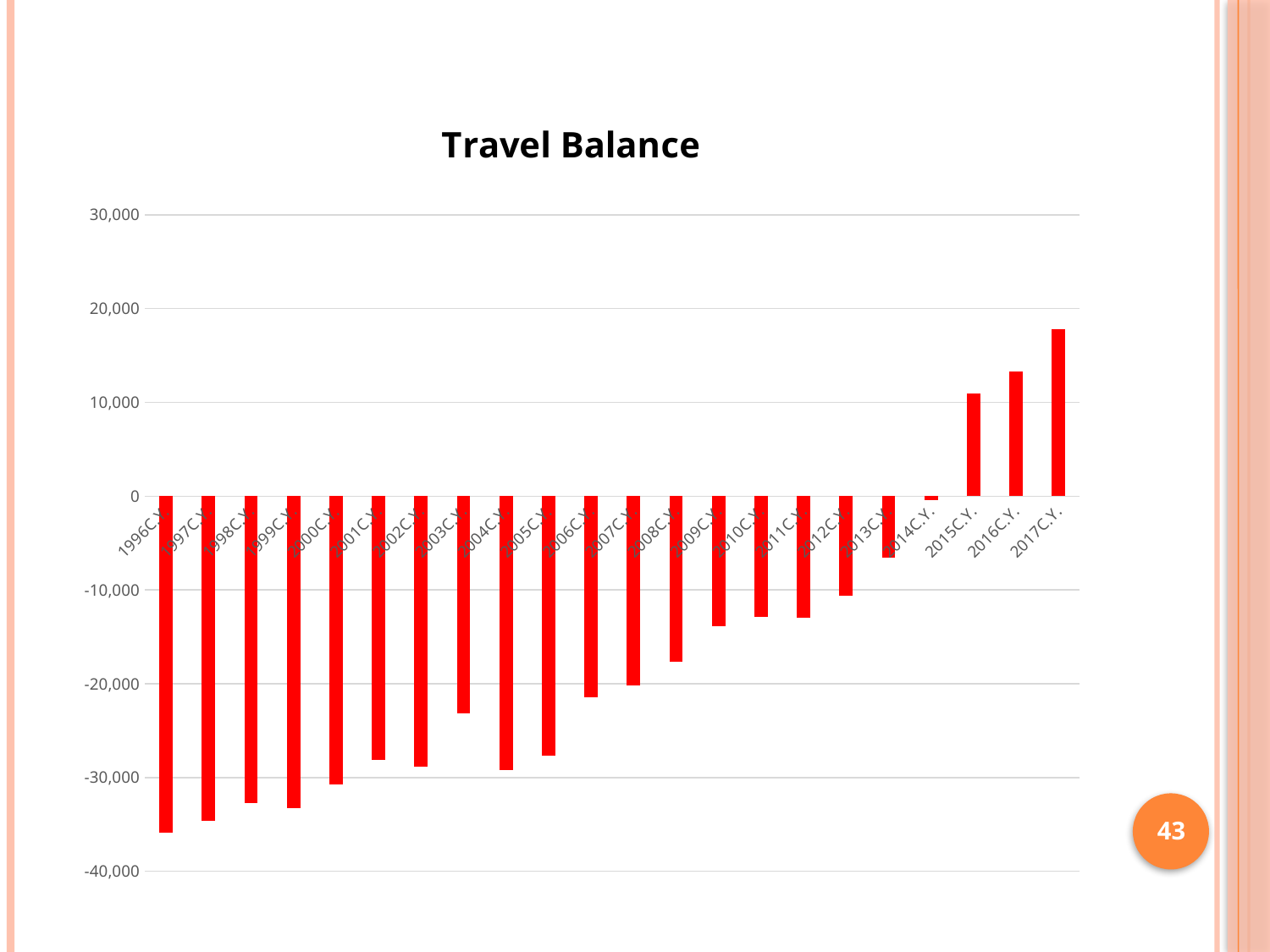
Overall, do the values rise or fall from 1996C.Y. to 2017C.Y.? rise What is the title of the chart? Travel Balance Is the value for 2013C.Y. greater or less than -10,000? greater How many years show a positive travel balance (bar above zero)? 3 Which is larger, the value for 2003C.Y. or the value for 2004C.Y.? 2003C.Y. What kind of chart is shown on the slide? Bar chart Which is larger, the value for 2016C.Y. or the value for 2017C.Y.? 2017C.Y. Is the value for 2017C.Y. greater or less than 10,000? greater Which year has the highest travel balance? 2017C.Y. How many years (categories) are plotted on the x axis? 22 Is the value for 2000C.Y. greater or less than -30,000? less